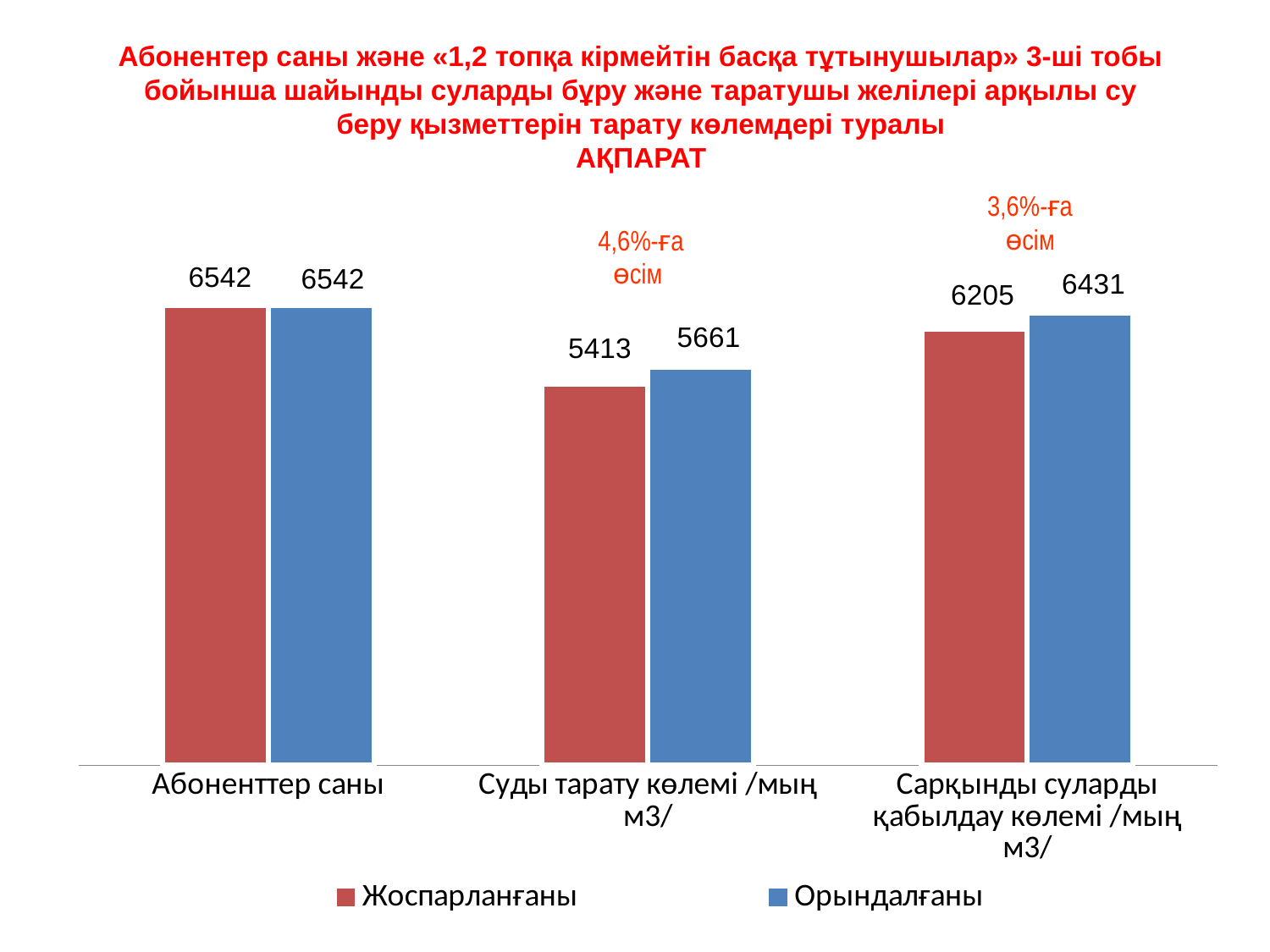
What is the difference between the Орындалғаны and Жоспарланғаны values for Суды тарату көлемі /мың м3/? 248 For Сарқынды суларды қабылдау көлемі /мың м3/, which is larger: Жоспарланғаны or Орындалғаны? Орындалғаны How many series does the legend list? 2 What is the Жоспарланғаны value for Абоненттер саны? 6542 How many categories are shown on the x axis? 3 Which category has the highest Орындалғаны value? Абоненттер саны What is the Жоспарланғаны value for Суды тарату көлемі /мың м3/? 5413 What is the difference between the Орындалғаны and Жоспарланғаны values for Сарқынды суларды қабылдау көлемі /мың м3/? 226 Which category has the lowest Жоспарланғаны value? Суды тарату көлемі /мың м3/ What is the Орындалғаны value for Сарқынды суларды қабылдау көлемі /мың м3/? 6431 What kind of chart is shown on the slide? Bar chart What is the Орындалғаны value for Суды тарату көлемі /мың м3/? 5661